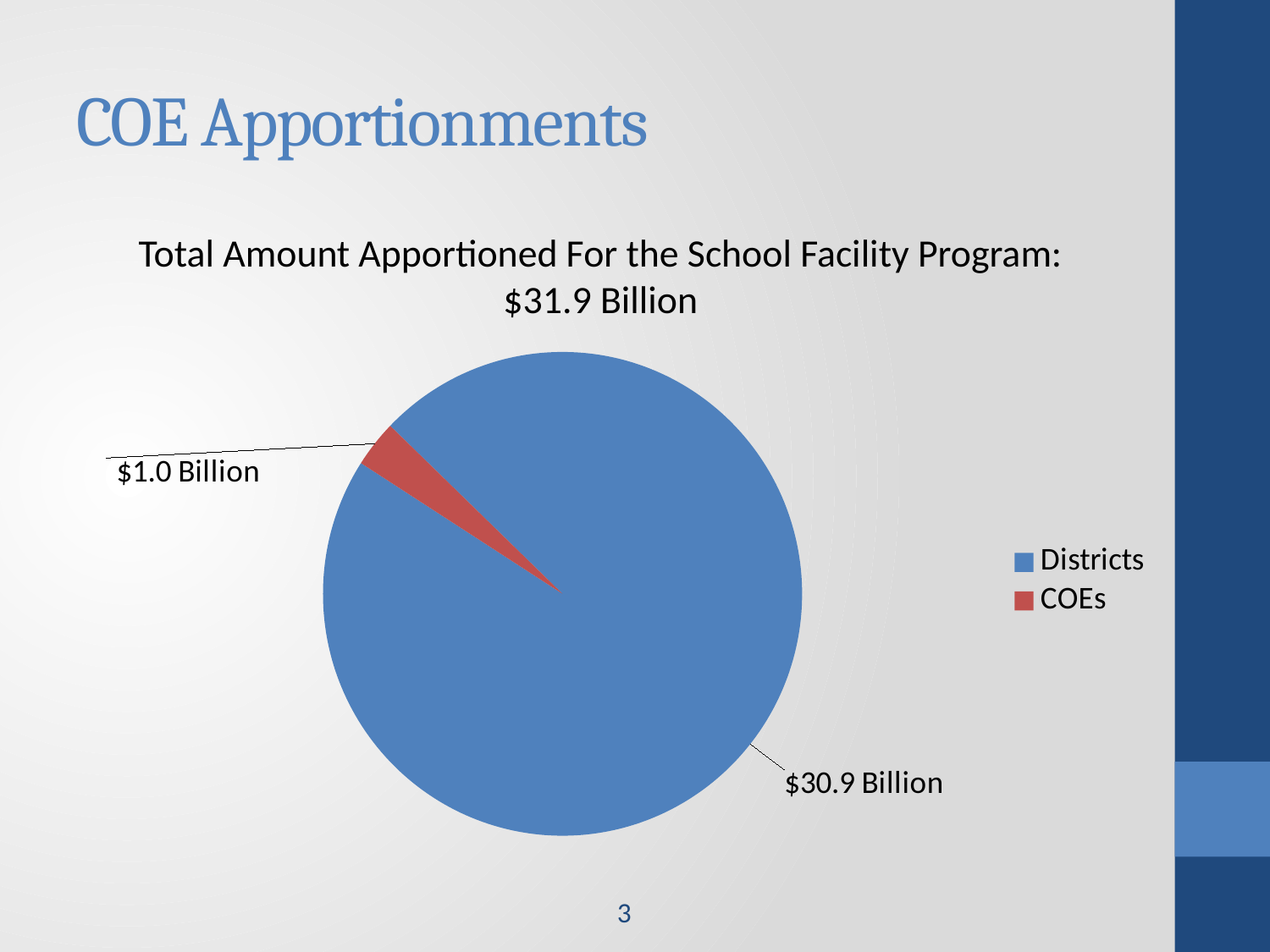
What is the difference between the Districts amount and the COEs amount? $29.9 Billion Which category has the largest slice of the pie chart? Districts What is the value for Districts in the pie chart? $30.9 Billion Which category has the smallest slice of the pie chart? COEs Which is larger, the amount for Districts or the amount for COEs? Districts What is the total amount apportioned for the School Facility Program according to the chart title? $31.9 Billion What colour is the COEs slice in the pie chart? red What is the value for COEs in the pie chart? $1.0 Billion How many categories does the pie chart show? 2 How many entries does the legend list? 2 What type of chart is shown on the slide? pie chart